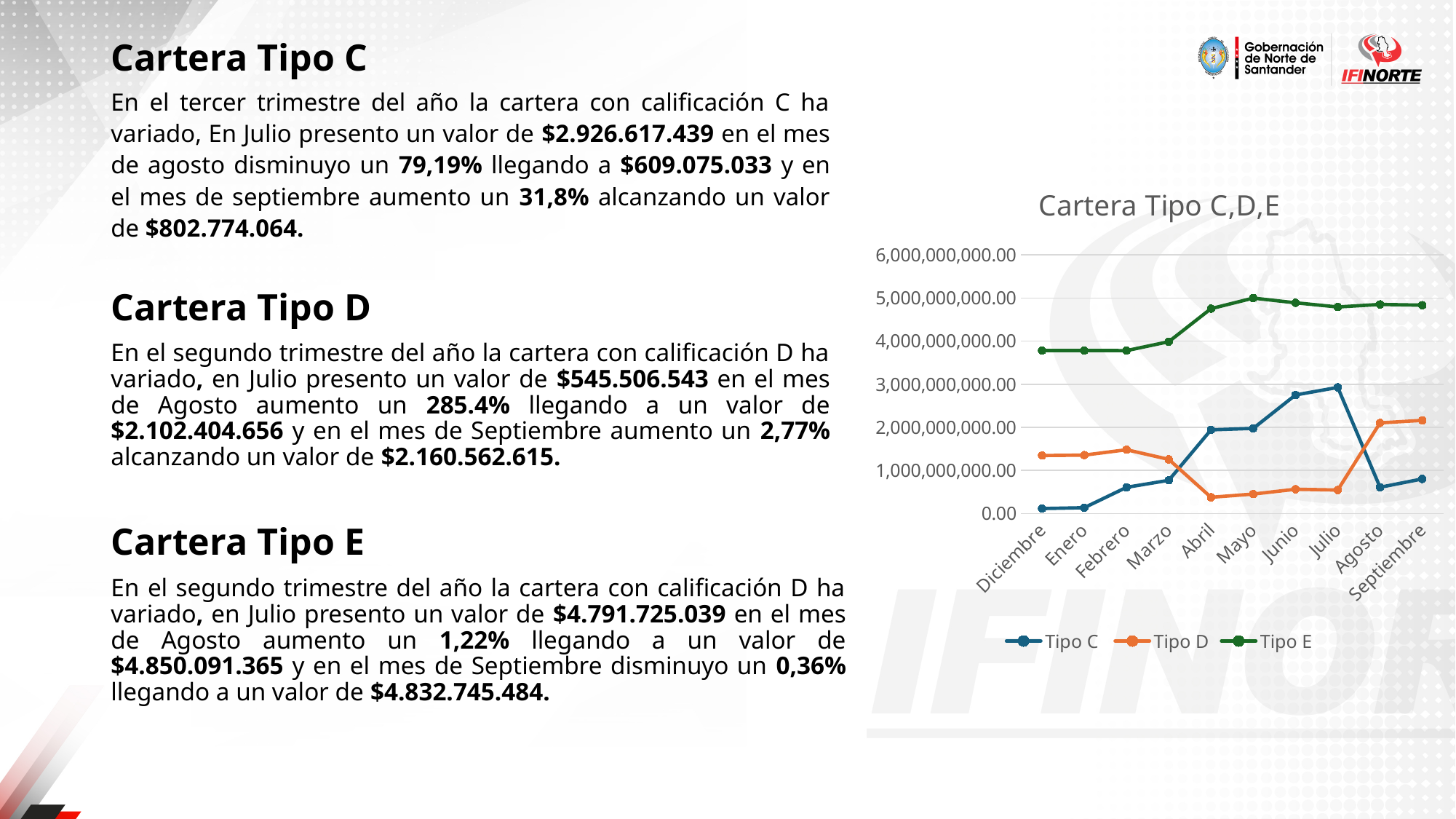
Does the Tipo E line rise or fall from Diciembre to Mayo? Rises What is the title of the chart? Cartera Tipo C,D,E Which colour is used for the Tipo E line in the chart? Green How many series does the chart legend list? 3 How many months are shown on the x axis of the chart? 10 Is the value for Tipo C in Julio greater or less than 2,000,000,000.00? greater In which month does the Tipo C line reach its highest value? Julio In which month does the Tipo D line reach its lowest value? Abril What kind of chart is shown on the slide? Line chart Is the value for Tipo E in Diciembre greater or less than 4,000,000,000.00? less In Agosto, which series has the larger value, Tipo C or Tipo D? Tipo D In which month does the Tipo E line reach its highest value? Mayo